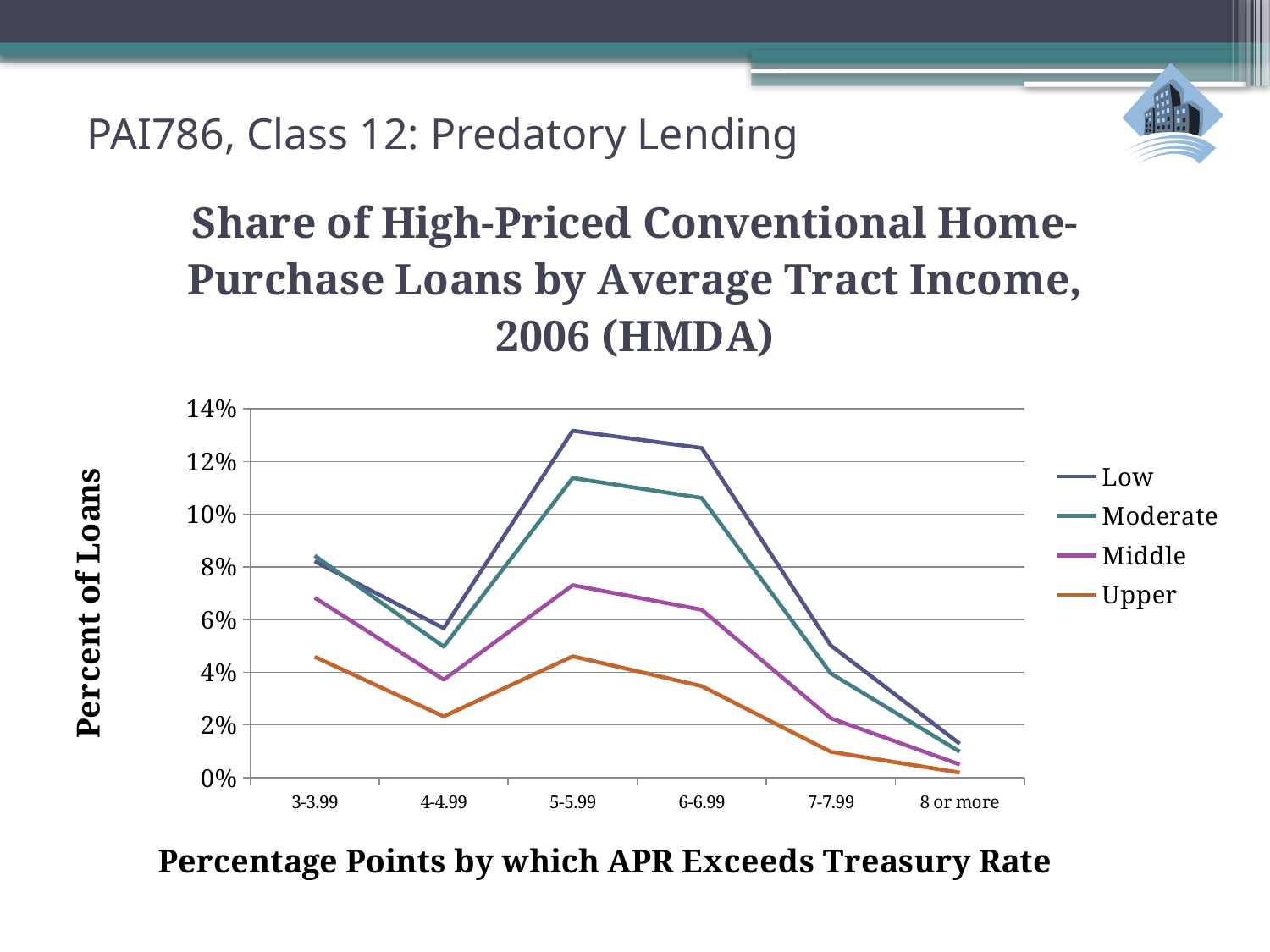
Is the value for Moderate at 5-5.99 greater or less than 10%? greater Is the value for Upper at 8 or more greater or less than 2%? less Is the value for Low at 5-5.99 greater or less than 12%? greater At 6-6.99, which is larger, the Moderate value or the Middle value? Moderate How many series does the legend list? 4 Do the values for the Low series rise or fall from 6-6.99 to 8 or more? Fall What is the label of the y axis? Percent of Loans Which series has the highest value at 5-5.99? Low What kind of chart is shown on the slide? Line chart How many categories are shown on the x axis? 6 For the Middle series, which category has the highest value? 5-5.99 For the Upper series, which category has the lowest value? 8 or more